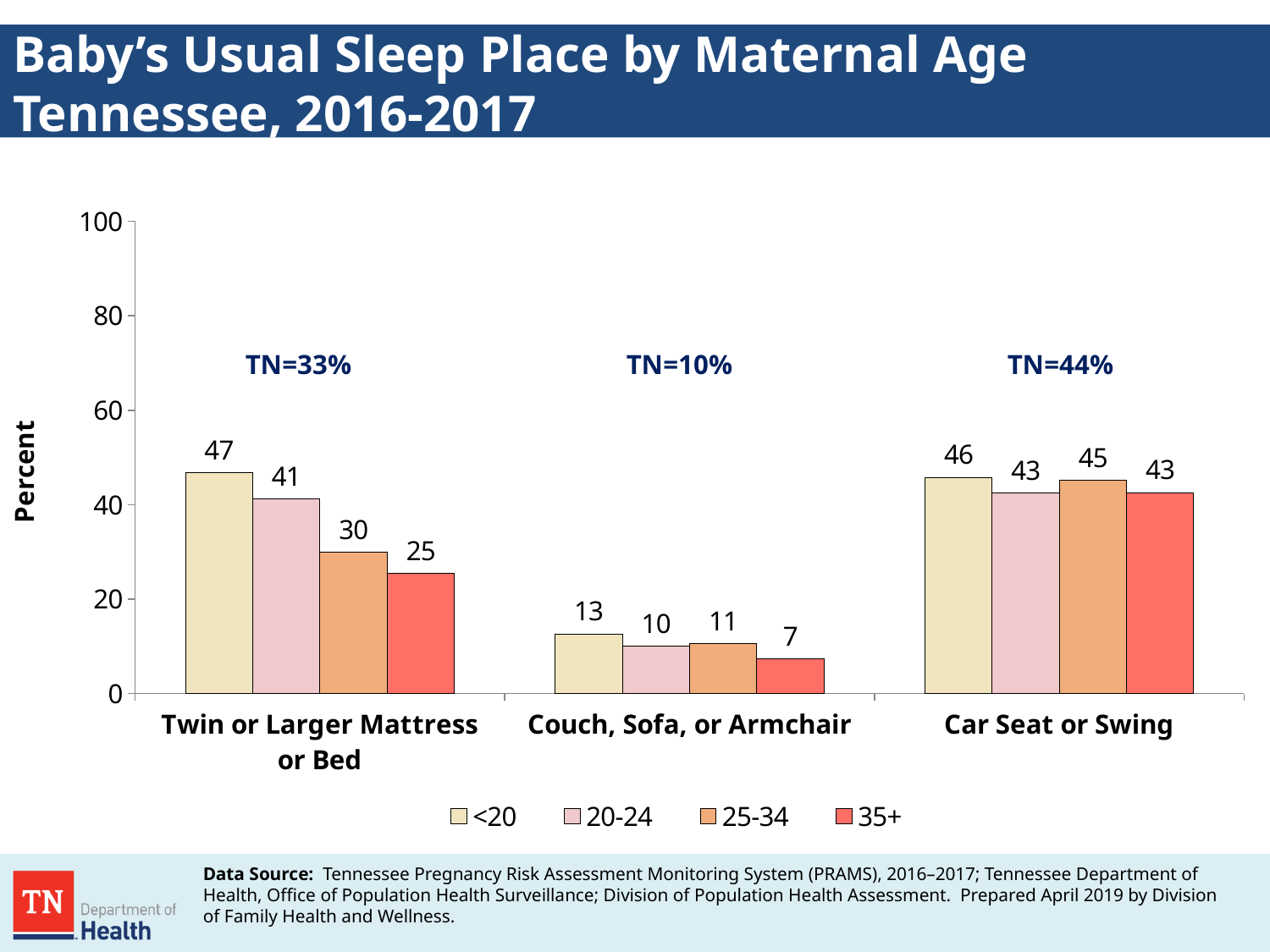
What is the value for the 35+ age group for Couch, Sofa, or Armchair? 7 What is the Tennessee overall percentage shown above the Car Seat or Swing bars? TN=44% Which age group has the lowest value for Couch, Sofa, or Armchair? 35+ Is the value for the 20-24 age group for Twin or Larger Mattress or Bed greater or less than 40? greater How many sleep place categories are shown on the x axis? 3 How many age groups does the legend list? 4 Which age group has the highest value for Twin or Larger Mattress or Bed? <20 Which is larger for Car Seat or Swing: the <20 value or the 20-24 value? <20 What is the value for the 25-34 age group for Car Seat or Swing? 45 What is the difference between the <20 and 35+ values for Twin or Larger Mattress or Bed? 22 What kind of chart is shown on the slide? Bar chart What is the value for the <20 age group for Twin or Larger Mattress or Bed? 47